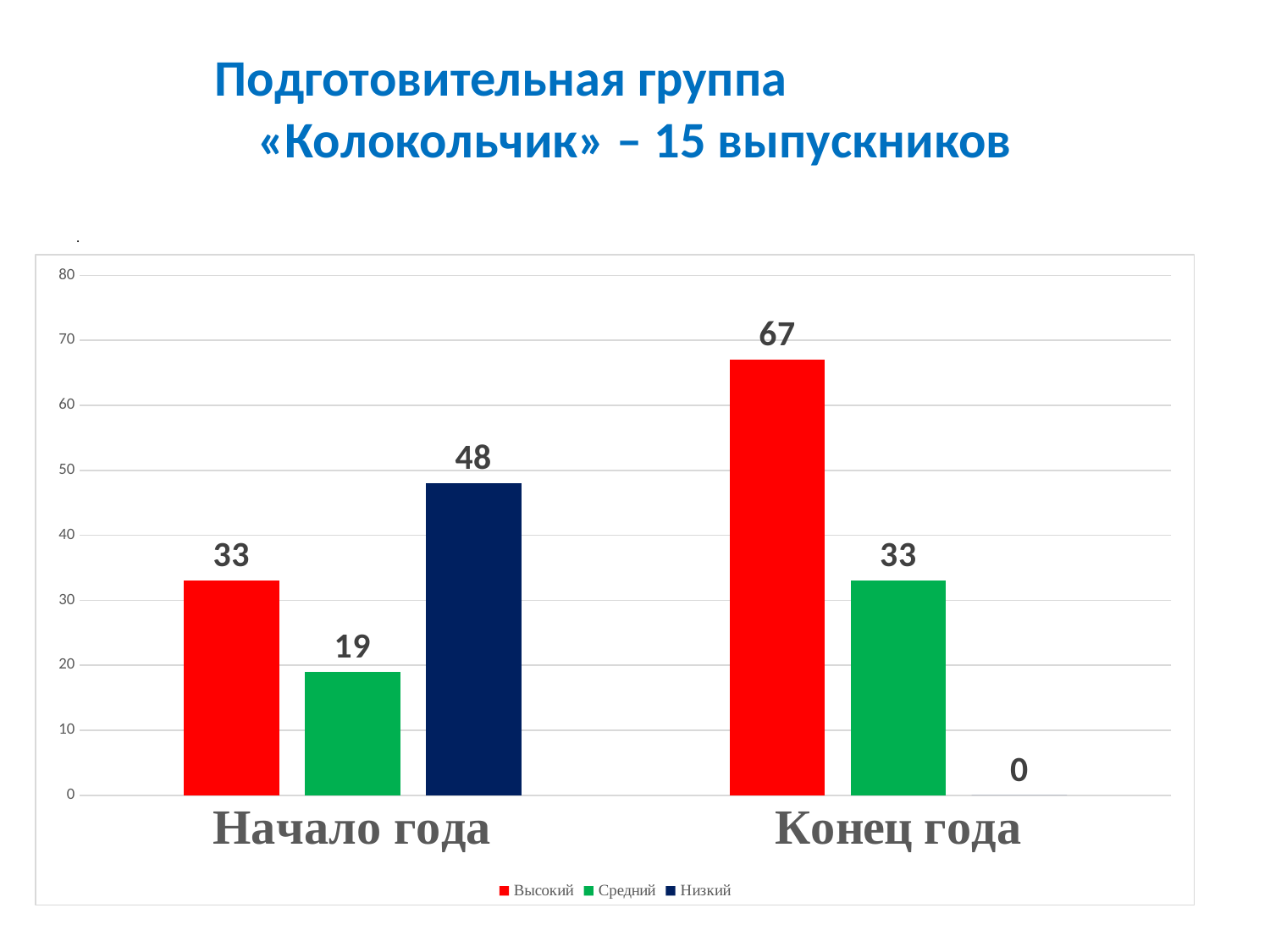
What is the difference between the Высокий values at Конец года and Начало года? 34 Which series has the lowest value at Конец года? Низкий What is the value for Высокий at Начало года? 33 Which series has the highest value at Начало года? Низкий What is the value for Высокий at Конец года? 67 Does the Высокий value rise or fall from Начало года to Конец года? Rise What is the value for Средний at Начало года? 19 What is the value for Низкий at Конец года? 0 What kind of chart is shown on the slide? Bar chart How many series does the legend list? 3 Which is larger: Средний at Начало года or Средний at Конец года? Средний at Конец года What is the value for Низкий at Начало года? 48